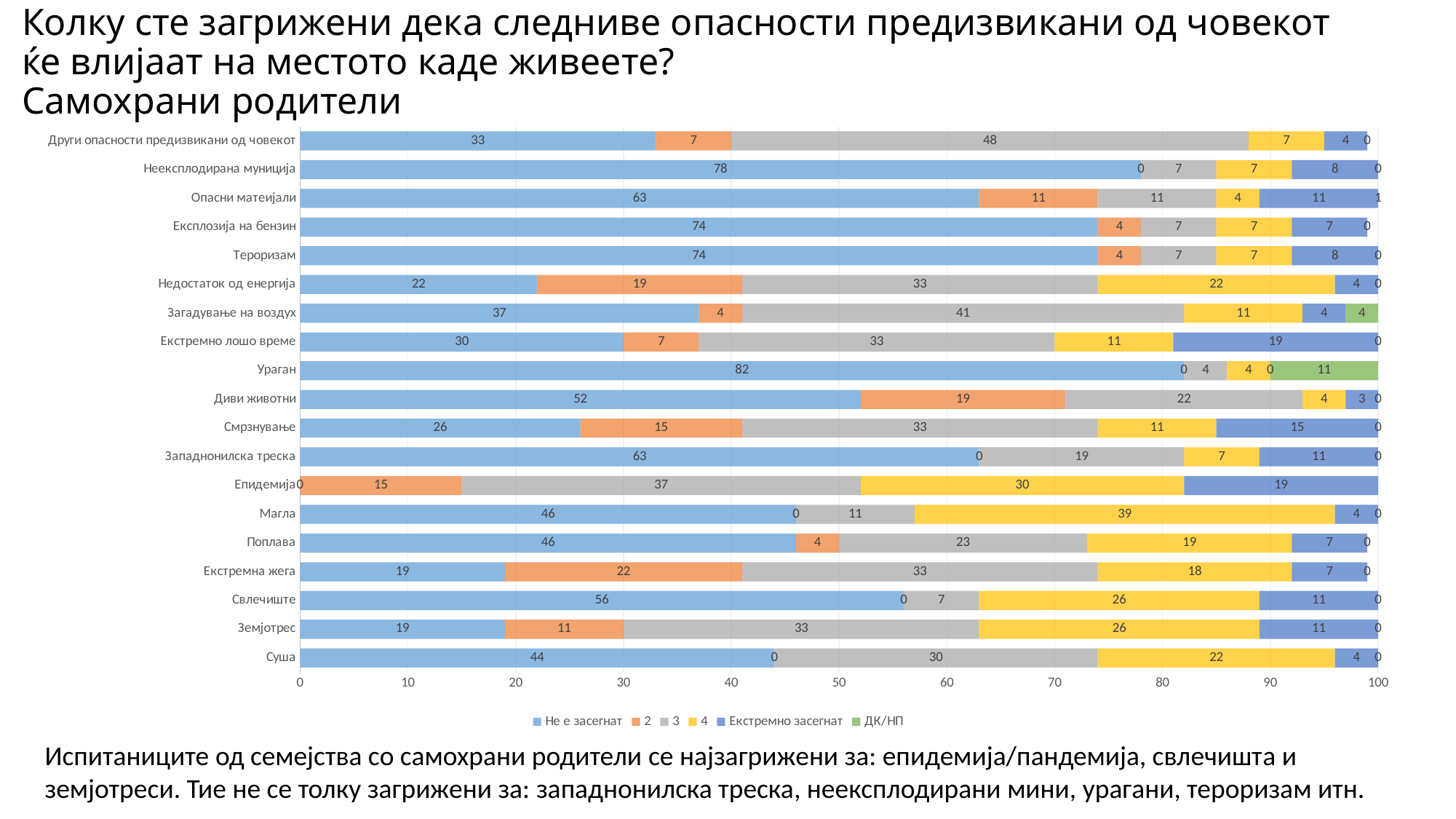
Which category has the lowest value for "Не е засегнат"? Епидемија What is the difference between the "Не е засегнат" values for Ураган and Неексплодирана муниција? 4 How many hazard categories are listed on the chart? 19 What is the value of "ДК/НП" for Ураган? 11 What kind of chart is shown on the slide? Stacked bar chart What is the value of "4" for Магла? 39 Which has the larger value for "4": Магла or Суша? Магла What is the value of "Не е засегнат" for Ураган? 82 What is the last entry in the legend? ДК/НП What is the difference between the "2" values for Екстремна жега and Земјотрес? 11 How many series does the legend list? 6 Which category has the highest value for "Не е засегнат"? Ураган